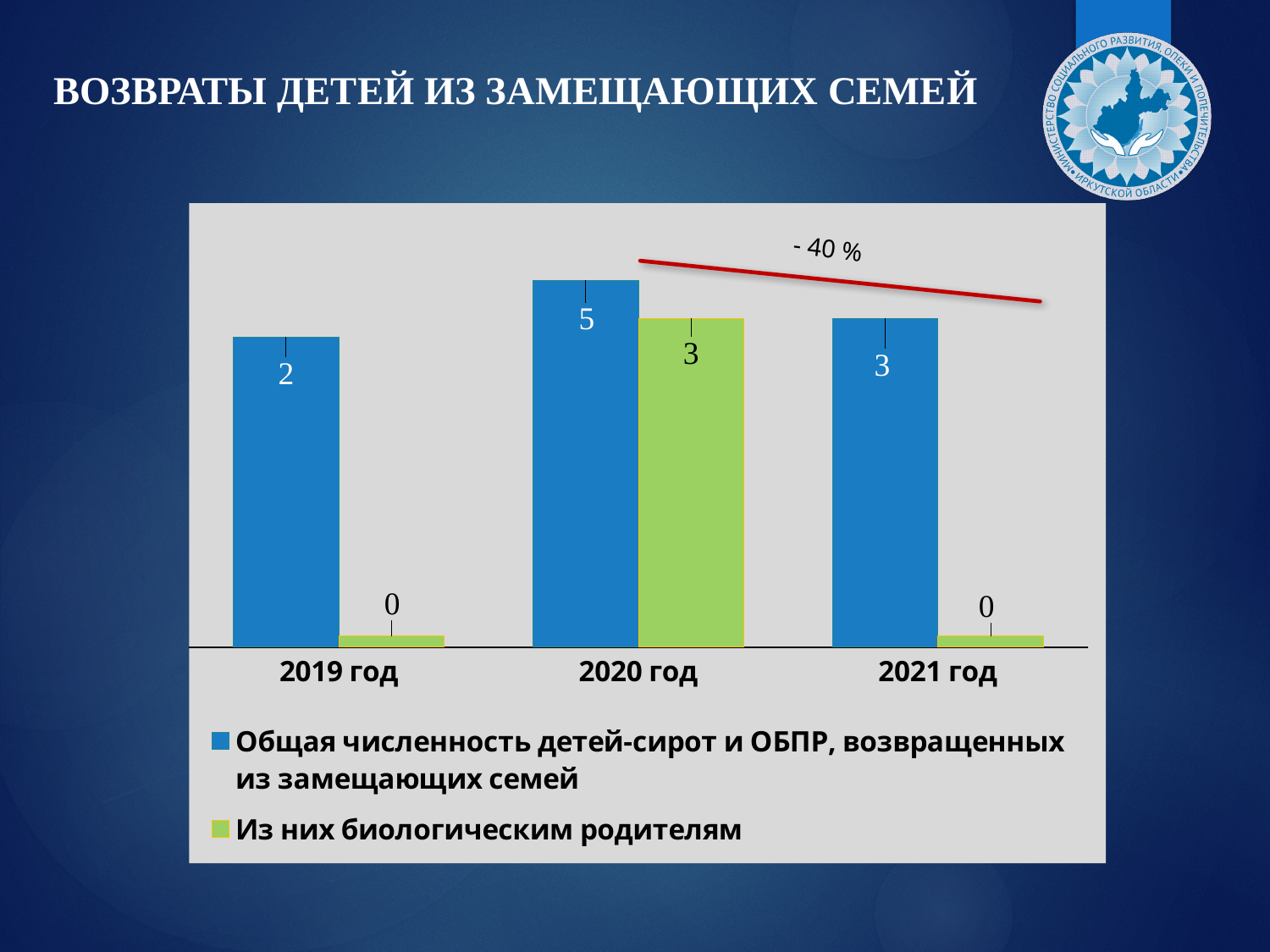
What is the value of the series "Из них биологическим родителям" for 2021 год? 0 In which year is the value of the series "Общая численность детей-сирот и ОБПР, возвращенных из замещающих семей" highest? 2020 год What percentage change is written above the chart next to the red line? - 40 % What is the value of the series "Из них биологическим родителям" for 2020 год? 3 How many series does the chart legend list? 2 In which year is the value of the series "Общая численность детей-сирот и ОБПР, возвращенных из замещающих семей" lowest? 2019 год How many years (categories) are shown on the x axis of the chart? 3 What kind of chart is shown on the slide? Bar chart What is the difference between the values of the series "Общая численность детей-сирот и ОБПР, возвращенных из замещающих семей" for 2020 год and 2021 год? 2 Which is larger: the value of "Общая численность детей-сирот и ОБПР, возвращенных из замещающих семей" for 2021 год or for 2019 год? 2021 год What is the value of the series "Общая численность детей-сирот и ОБПР, возвращенных из замещающих семей" for 2019 год? 2 What is the value of the series "Общая численность детей-сирот и ОБПР, возвращенных из замещающих семей" for 2020 год? 5